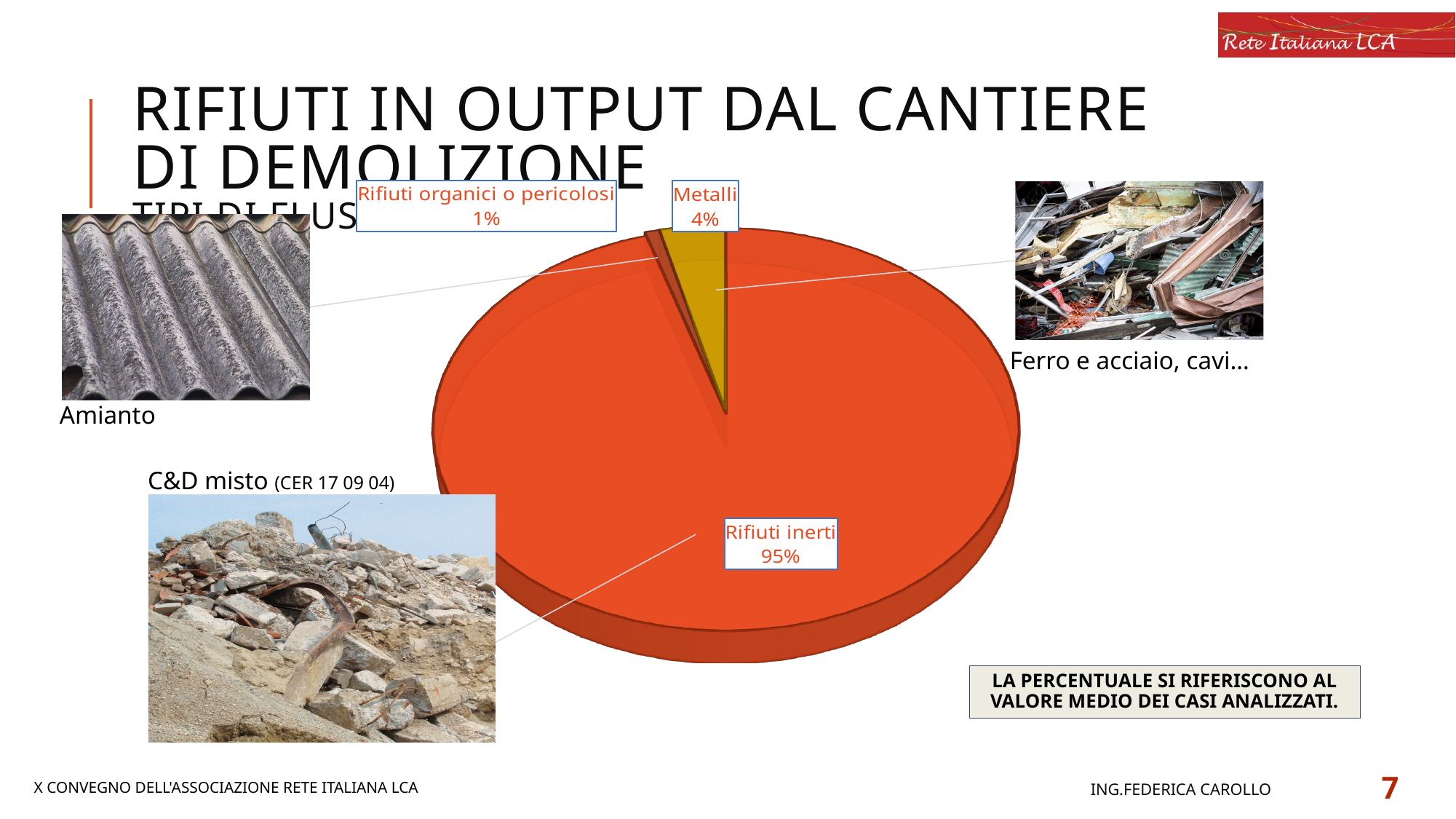
What percentage of the pie is labelled "Rifiuti organici o pericolosi"? 1% Which slice of the pie chart is the largest? Rifiuti inerti How many slices does the pie chart have? 3 Which slice of the pie chart is the smallest? Rifiuti organici o pericolosi What is the difference in percentage points between the "Metalli" slice and the "Rifiuti organici o pericolosi" slice? 3 What percentage of the pie is labelled "Rifiuti inerti"? 95% What percentage of the pie is labelled "Metalli"? 4% What kind of chart is shown on the slide? pie chart What share of the pie does the "Rifiuti inerti" slice represent? 95% What colour is the "Metalli" slice in the pie chart? yellow Which is larger in the pie chart, "Metalli" or "Rifiuti organici o pericolosi"? Metalli What is the difference in percentage points between the "Rifiuti inerti" slice and the "Metalli" slice? 91